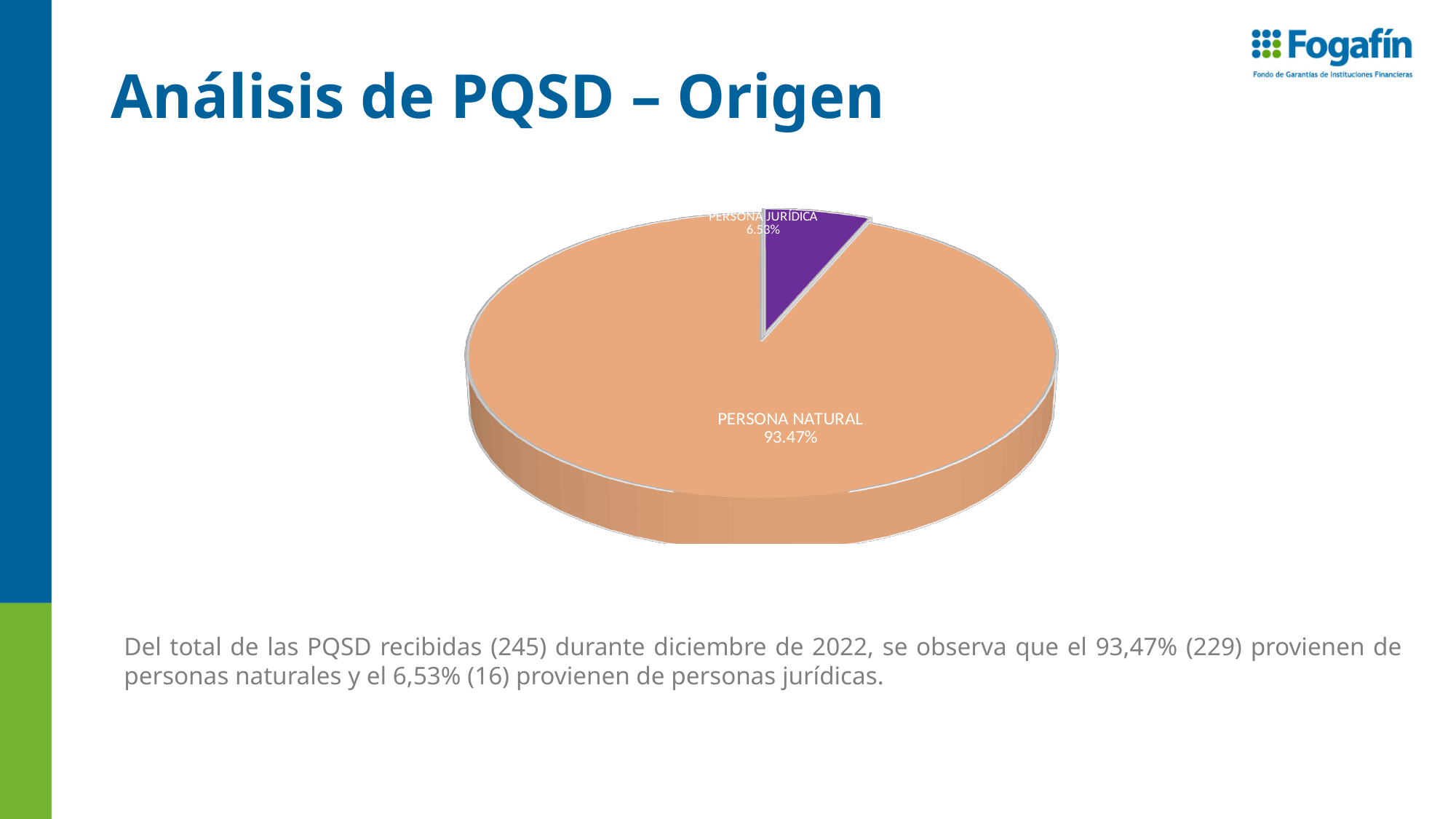
What share of the pie does PERSONA NATURAL represent? 93.47% What colour is the PERSONA JURÍDICA slice? Purple What is the difference in percentage points between the PERSONA NATURAL and PERSONA JURÍDICA slices? 86.94% Which slice of the pie chart is the largest? PERSONA NATURAL Which slice of the pie chart is the smallest? PERSONA JURÍDICA How many slices does the pie chart have? 2 Which is larger, the PERSONA NATURAL slice or the PERSONA JURÍDICA slice? PERSONA NATURAL What share of the pie does PERSONA JURÍDICA represent? 6.53% What kind of chart is shown on the slide? Pie chart What colour is the PERSONA NATURAL slice? Orange